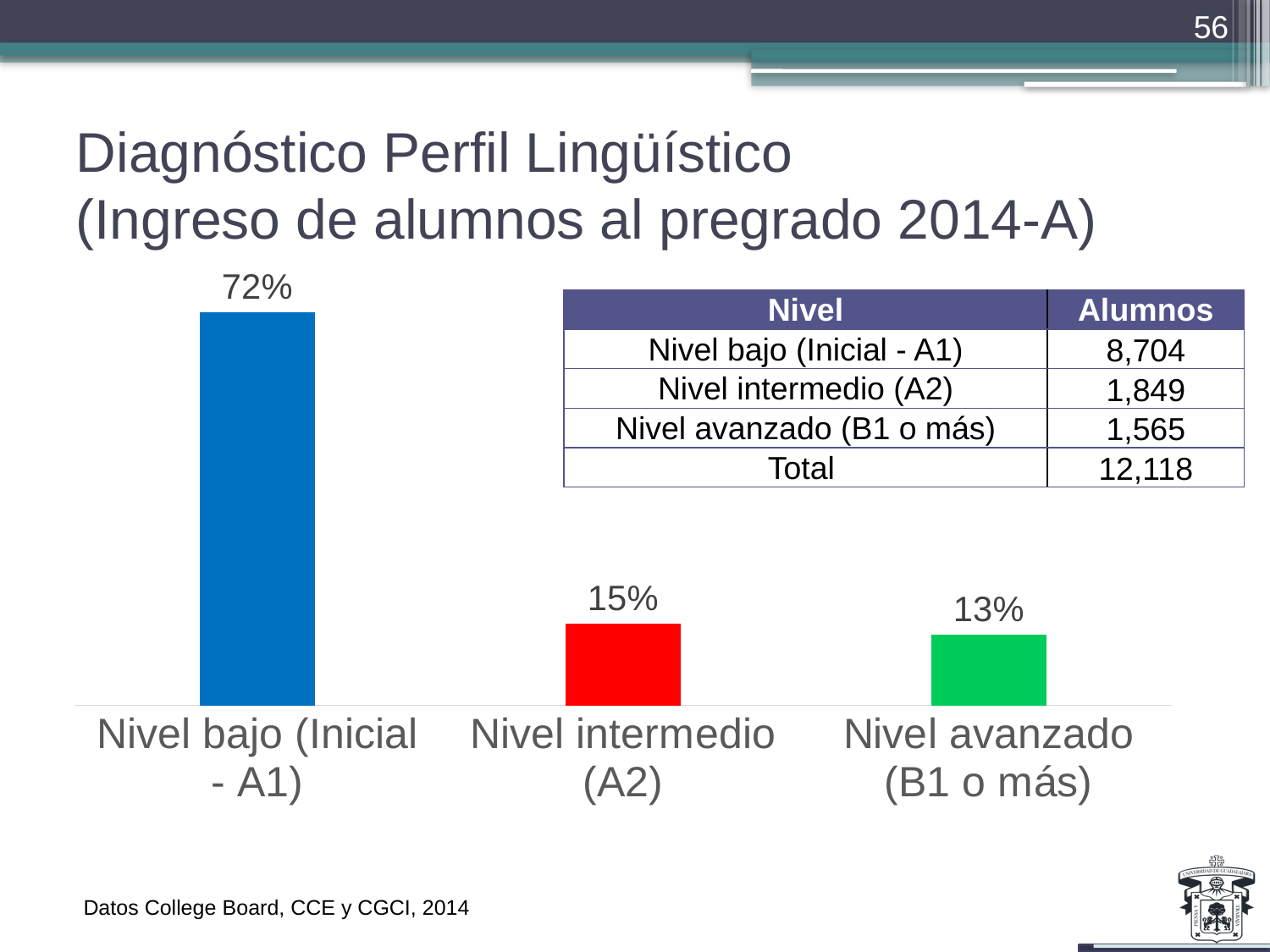
Which category has the highest value? Nivel bajo (Inicial - A1) Which category has the lowest value? Nivel avanzado (B1 o más) What is the value for Nivel avanzado (B1 o más)? 13% What is the difference between the values for Nivel intermedio (A2) and Nivel avanzado (B1 o más)? 2% Which is larger, the value for Nivel intermedio (A2) or Nivel avanzado (B1 o más)? Nivel intermedio (A2) What is the difference between the values for Nivel bajo (Inicial - A1) and Nivel intermedio (A2)? 57% What kind of chart is shown on the slide? Bar chart What is the value for Nivel bajo (Inicial - A1)? 72% What colour is the bar for Nivel intermedio (A2)? Red What is the value for Nivel intermedio (A2)? 15% Do the values rise or fall from left to right across the categories? Fall How many categories are shown in the chart? 3